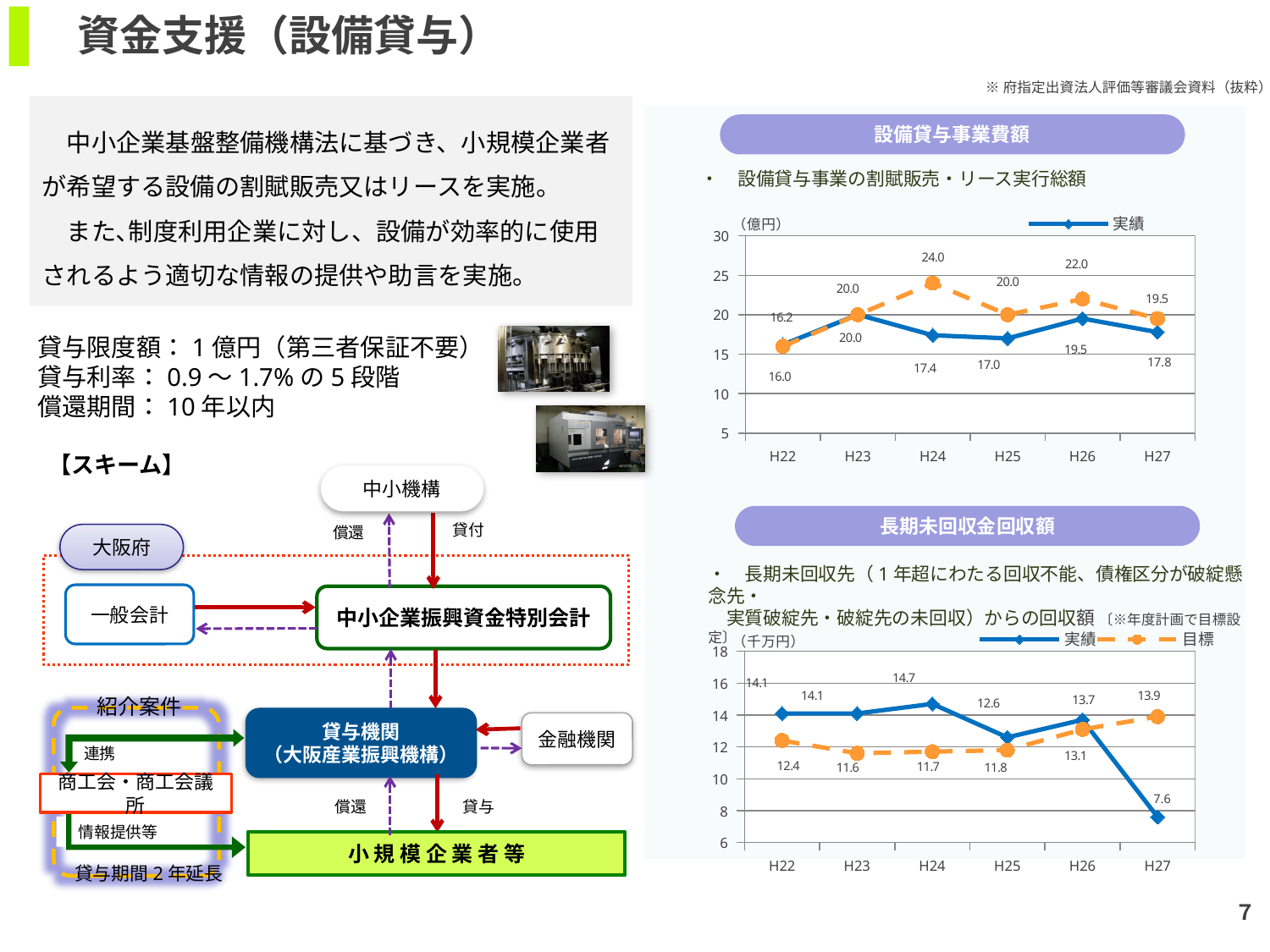
In the 設備貸与事業費額 chart, what is the difference between the orange dashed value (22.0) and the 実績 value (19.5) for H26? 2.5 In the 長期未回収金回収額 chart, what is the 実績 value for H27? 7.6 How many series does the legend of the 長期未回収金回収額 chart list? 2 In the 長期未回収金回収額 chart, which year has the lowest 実績 value? H27 How many years are shown on the x axis of the 設備貸与事業費額 chart? 6 In the 長期未回収金回収額 chart, which is larger for H26: 実績 or 目標? 実績 In the 設備貸与事業費額 chart, what is the orange dashed (目標) value for H24? 24.0 What unit is shown on the y axis of the 設備貸与事業費額 chart? 億円 In the 設備貸与事業費額 chart, which year has the highest orange dashed (目標) value? H24 What kind of chart is the 設備貸与事業費額 chart? line chart In the 長期未回収金回収額 chart, which year has the highest 目標 value? H27 In the 設備貸与事業費額 chart, what is the 実績 value for H24? 17.4